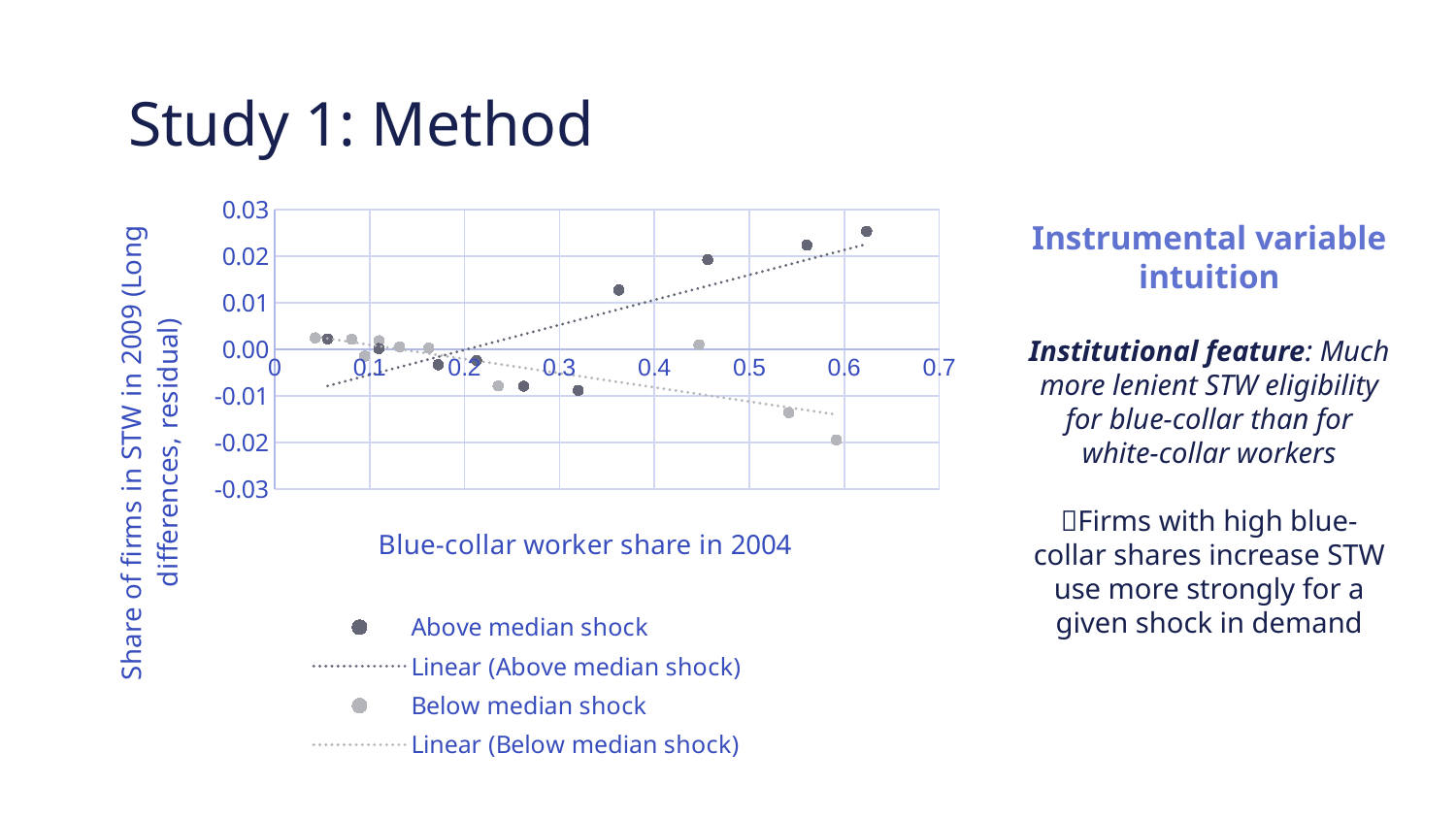
Which series reaches the highest y value on the chart, Above median shock or Below median shock? Above median shock Does the Linear (Below median shock) trendline rise or fall as the blue-collar worker share increases? fall What is the highest value shown on the y axis of the chart? 0.03 Is the value for the rightmost Above median shock point (near x = 0.6) greater or less than 0.02? greater What is the y-axis title of the chart? Share of firms in STW in 2009 (Long differences, residual) Near x = 0.6, which point is larger: the Above median shock point or the Below median shock point? Above median shock What is the x-axis title of the chart? Blue-collar worker share in 2004 Which series reaches the lowest y value on the chart, Above median shock or Below median shock? Below median shock What kind of chart is shown on the slide? scatter chart Does the Linear (Above median shock) trendline rise or fall as the blue-collar worker share increases? rise How many entries does the chart legend list? 4 Is the value for the rightmost Below median shock point (near x = 0.6) greater or less than -0.01? less